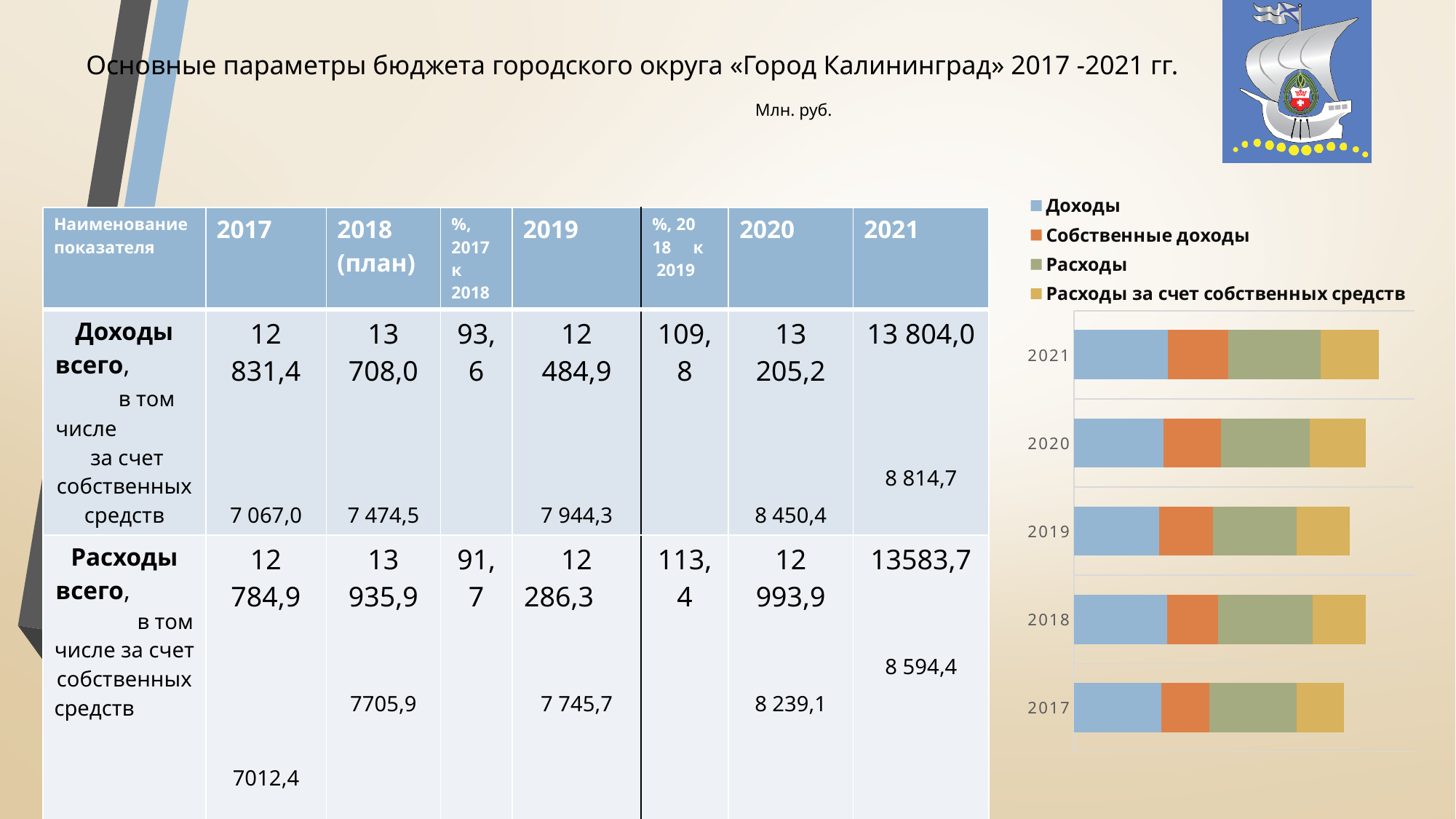
According to the table on the slide, which is larger for 2018 (план): Доходы всего or Расходы всего? Расходы всего How many years (categories) are plotted on the bar chart? 5 According to the table on the slide, which year has the highest Доходы всего? 2021 According to the table on the slide, what is the value of Доходы всего for 2021? 13 804,0 Which years are shown as categories on the bar chart? 2017, 2018, 2019, 2020, 2021 Which series in the bar chart is shown in blue? Доходы How many series does the legend of the bar chart list? 4 According to the table on the slide, what is the value of Доходы за счет собственных средств for 2020? 8 450,4 What kind of chart is shown on the right side of the slide? Stacked horizontal bar chart According to the table on the slide, what is the value of Расходы всего for 2019? 12 286,3